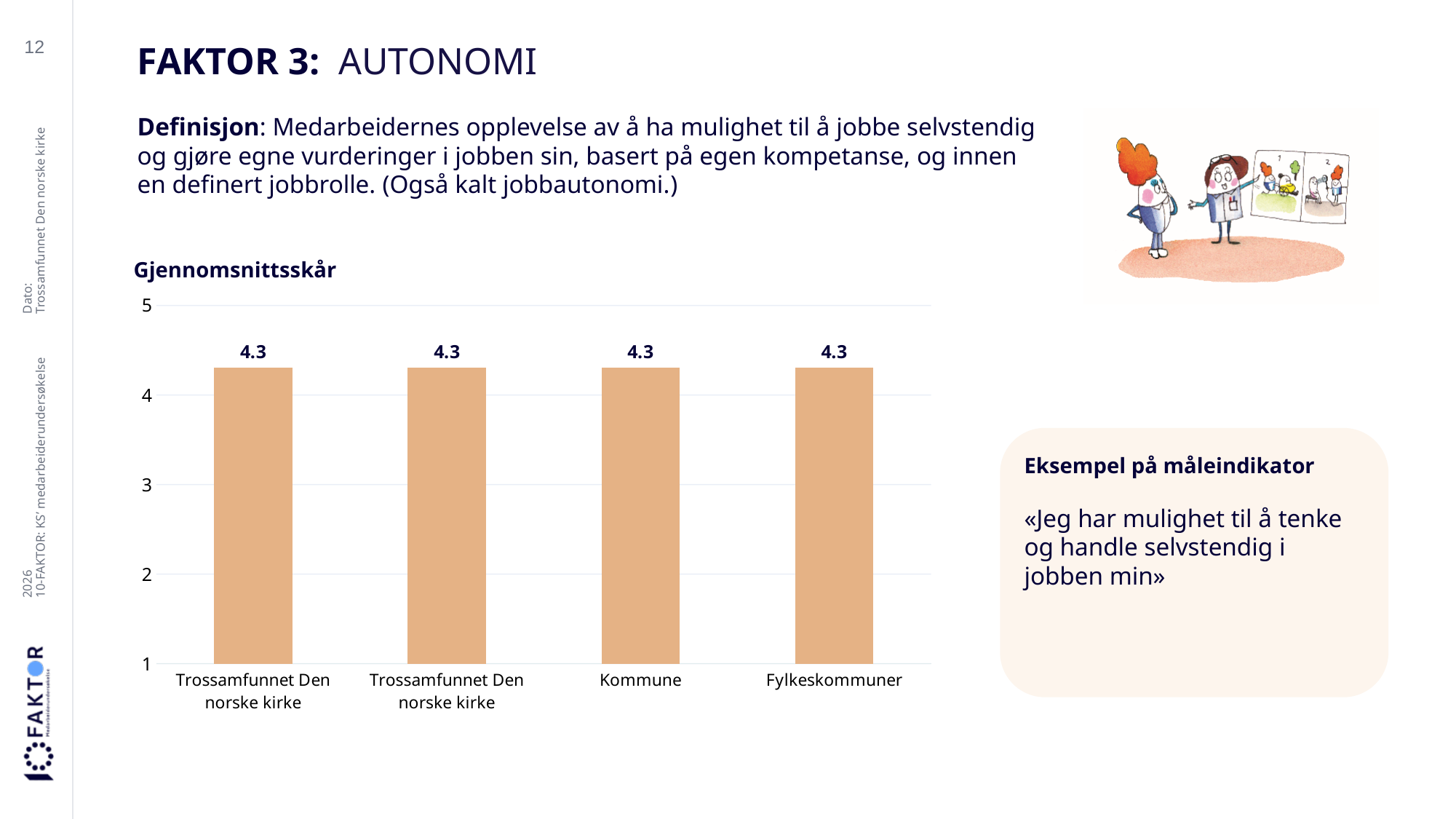
What is the value shown for the first bar, Trossamfunnet Den norske kirke? 4.3 What is the value for Kommune? 4.3 What is the difference between the values for Kommune and Fylkeskommuner? 0 How many bars are shown in the chart? 4 Do the values rise, fall or stay the same across the categories from left to right? stay the same Is the value for Fylkeskommuner greater or less than 5? less Is the value for Kommune greater or less than 4? greater What kind of chart is shown on the slide? bar chart What is the highest value shown on the vertical axis? 5 What is the value for Fylkeskommuner? 4.3 What is the title of the chart? Gjennomsnittsskår